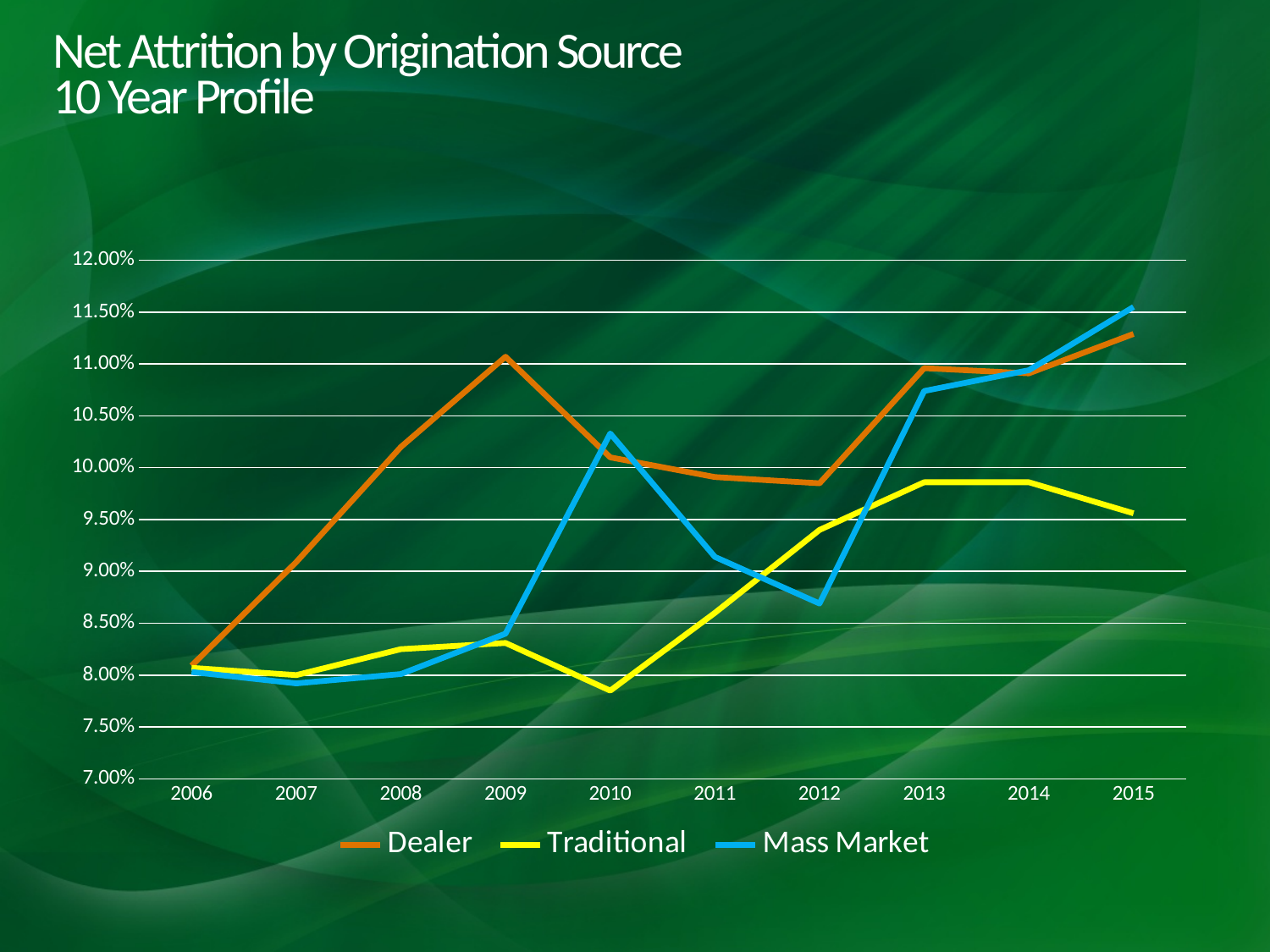
In which year is the Traditional series at its lowest? 2010 Is the Mass Market value for 2015 greater or less than 11.00%? greater Is the Dealer value for 2009 greater or less than 10.50%? greater How many series does the legend list? 3 How many years are shown on the x axis? 10 In 2012, which is larger: the Traditional value or the Mass Market value? Traditional Which series has the highest value in 2015? Mass Market Does the Dealer series rise or fall from 2006 to 2009? Rise Is the Traditional value for 2010 greater or less than 8.00%? less Which series has the highest value in 2009? Dealer What kind of chart is shown on the slide? Line chart Which series has the lowest value in 2012? Mass Market